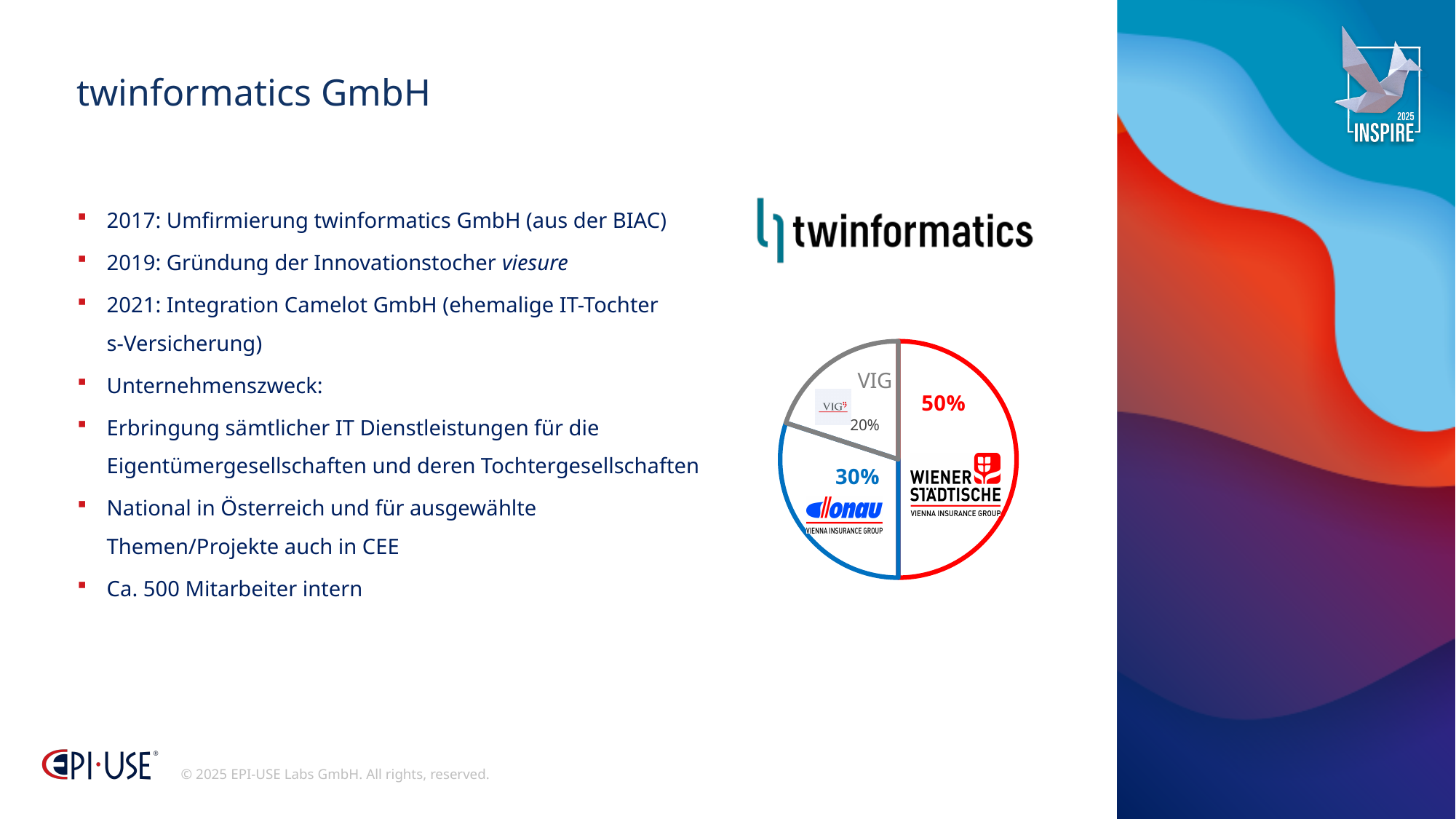
What share of the pie chart does Donau hold? 30% What share of the pie chart does VIG hold? 20% What share of the pie chart does Wiener Städtische hold? 50% How many slices does the pie chart have? 3 What is the difference in percentage points between the Wiener Städtische slice and the Donau slice? 20 Which slice of the pie chart is the smallest? VIG What colour is the outline of the Donau slice in the pie chart? blue What colour is the outline of the Wiener Städtische slice in the pie chart? red What kind of chart is shown on the slide? pie chart Which slice of the pie chart is the largest? Wiener Städtische What is the difference in percentage points between the Donau slice and the VIG slice? 10 Which is larger in the pie chart, the Donau slice or the VIG slice? Donau